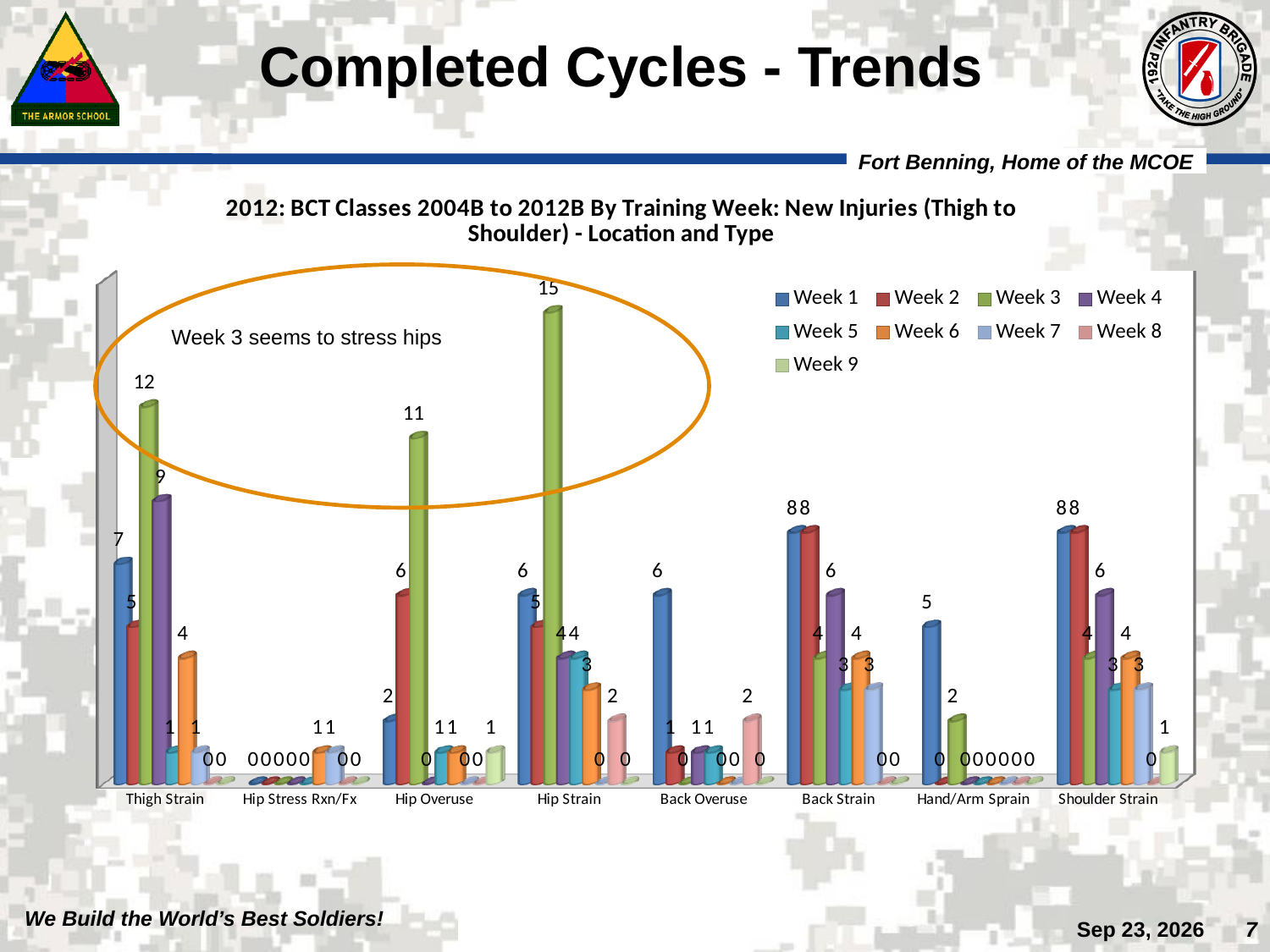
How many injury categories are shown on the x axis? 8 Which is larger for Thigh Strain: the Week 1 value or the Week 2 value? Week 1 What is the Week 1 value for Hand/Arm Sprain? 5 What is the Week 4 value for Thigh Strain? 9 What is the Week 3 value for Hip Strain? 15 What is the Week 3 value for Thigh Strain? 12 What is the Week 1 value for Back Strain? 8 What kind of chart is shown on the slide? Bar chart Which injury category has the highest Week 3 value? Hip Strain How many series does the legend list? 9 What does the annotation inside the orange circle on the chart say? Week 3 seems to stress hips What is the difference between the Week 3 values for Hip Strain and Hip Overuse? 4